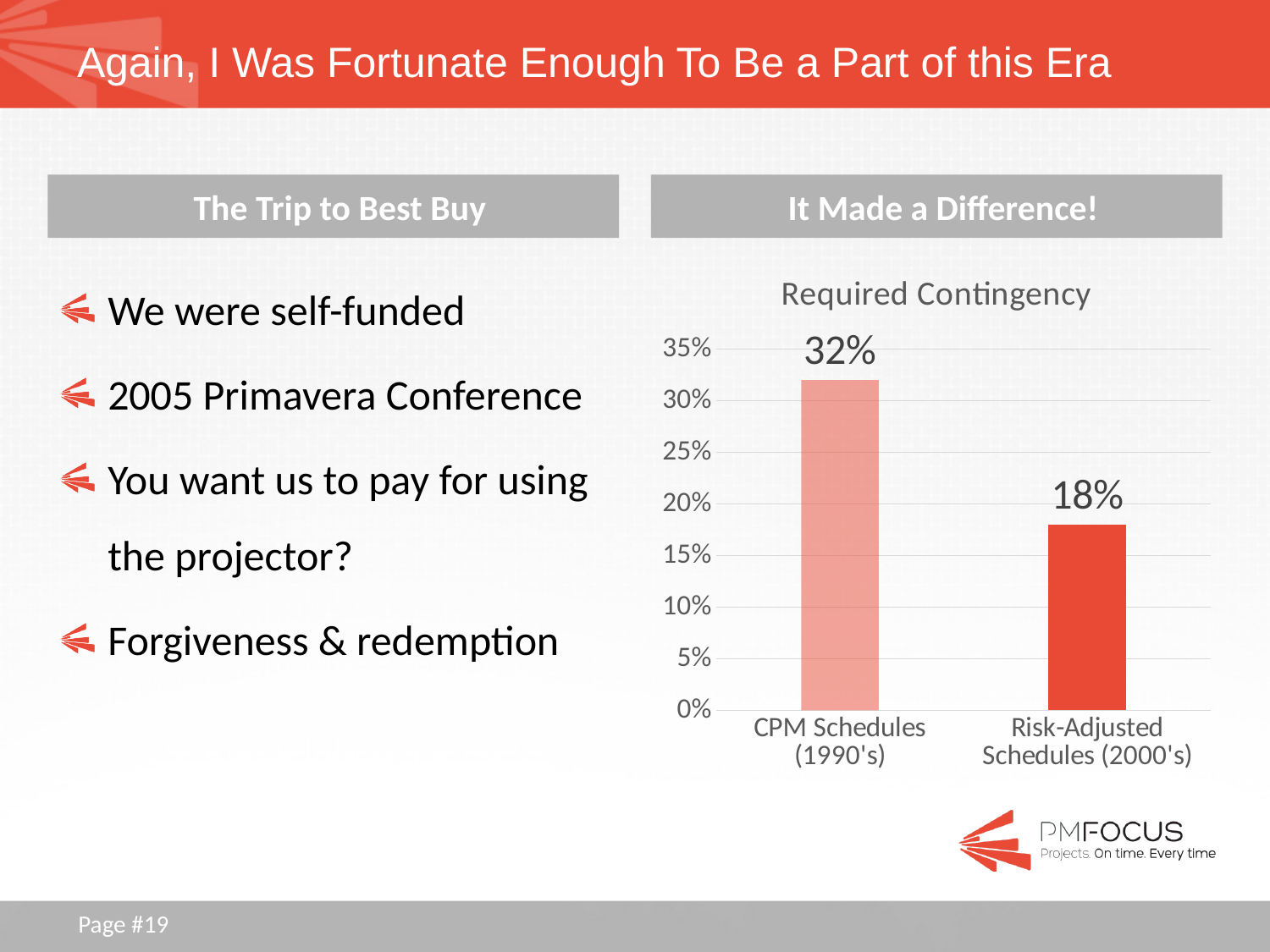
What is the difference in required contingency between CPM Schedules (1990's) and Risk-Adjusted Schedules (2000's)? 14% What is the required contingency for Risk-Adjusted Schedules (2000's)? 18% What is the required contingency for CPM Schedules (1990's)? 32% Is the value for CPM Schedules (1990's) greater or less than 30%? greater Is the value for Risk-Adjusted Schedules (2000's) greater or less than 20%? less How many categories are shown in the chart? 2 Do the values rise or fall from left to right across the x axis? fall What is the title of the chart? Required Contingency Which is larger, the required contingency for CPM Schedules (1990's) or for Risk-Adjusted Schedules (2000's)? CPM Schedules (1990's) Which category has the lowest required contingency? Risk-Adjusted Schedules (2000's) Which category has the highest required contingency? CPM Schedules (1990's) What kind of chart is shown on the slide? bar chart